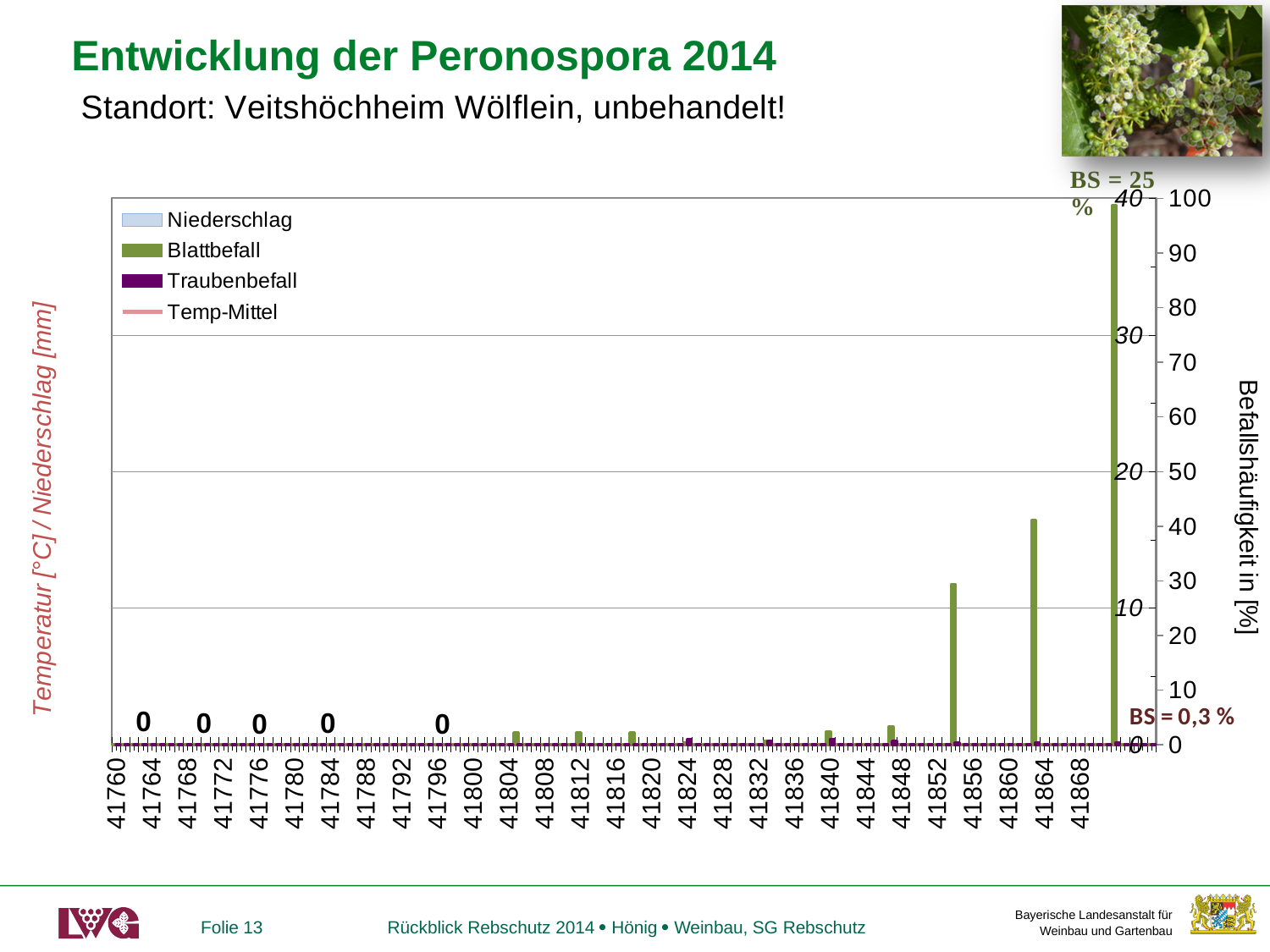
Which Blattbefall bar is taller, the one near 41852 or the one near 41864? the one near 41864 What is the first category label on the x axis? 41760 Is the tallest Blattbefall bar greater or less than 90 on the right-hand axis? greater How many series does the chart legend list? 4 Which series is shown in green in the legend? Blattbefall How many data labels reading "0" are printed above the early part of the chart? 5 Is the Blattbefall bar near 41852 greater or less than 20 on the right-hand axis? greater What kind of chart is shown on the slide? bar chart What is the label of the right-hand vertical axis? Befallshäufigkeit in [%] Is the Blattbefall bar near 41864 greater or less than 50 on the right-hand axis? less Do the Blattbefall values rise or fall along the x axis? rise What is the highest tick value on the right-hand vertical axis? 100